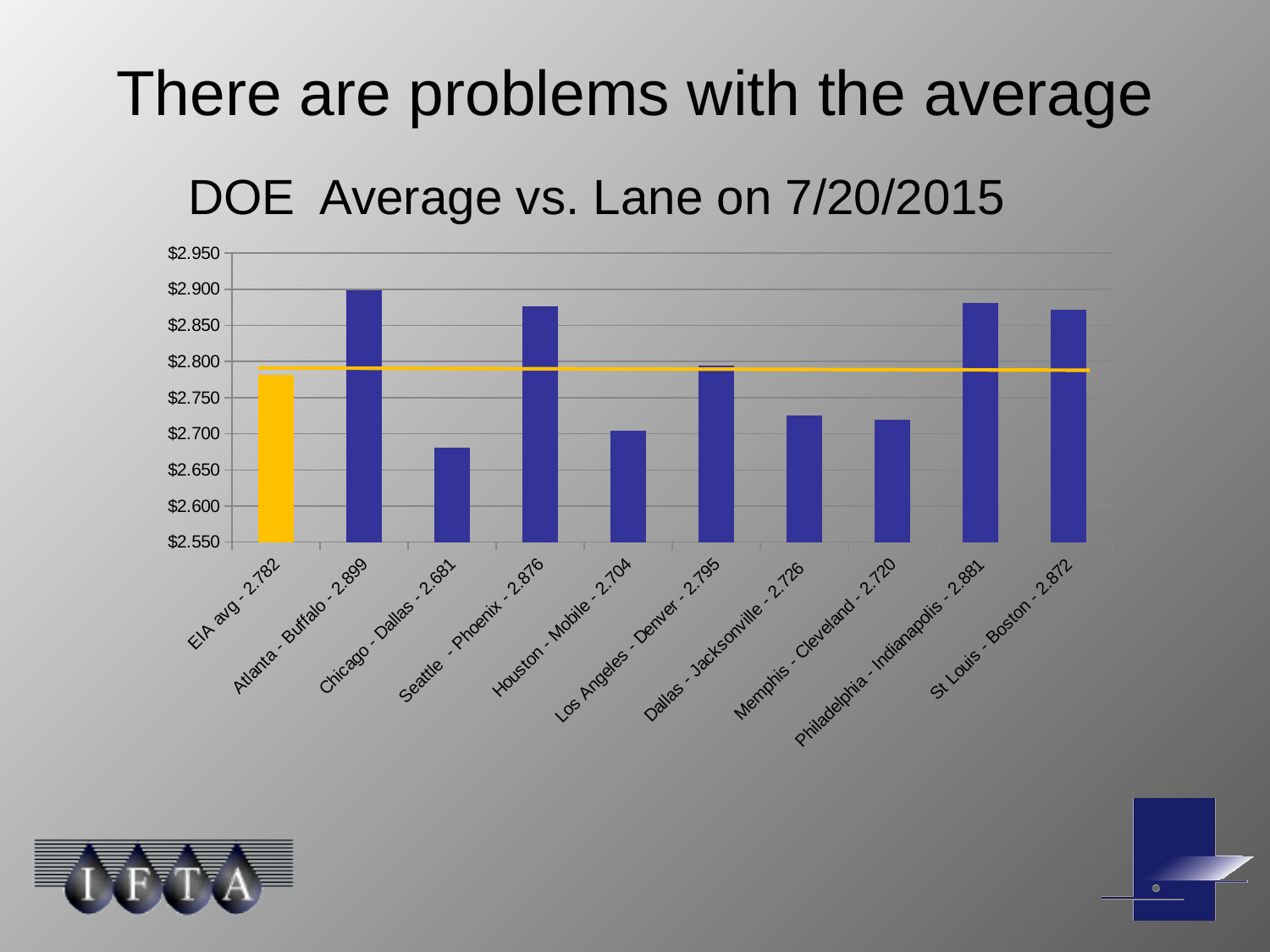
Which lane has the lowest value in the chart? Chicago - Dallas What is the difference between the Atlanta - Buffalo value and the Chicago - Dallas value? 0.218 What value is shown for the Philadelphia - Indianapolis lane? 2.881 What kind of chart is shown on the slide? bar chart What is the title of the chart? DOE Average vs. Lane on 7/20/2015 Which bar is coloured differently (orange/yellow) from the rest? EIA avg What value is shown for the EIA avg bar? 2.782 What value is shown for the Houston - Mobile lane? 2.704 How many bars are plotted in the chart? 10 Which is larger, the value for Dallas - Jacksonville or the value for Memphis - Cleveland? Dallas - Jacksonville Which lane has the highest value in the chart? Atlanta - Buffalo Is the value for Houston - Mobile greater or less than $2.750? less